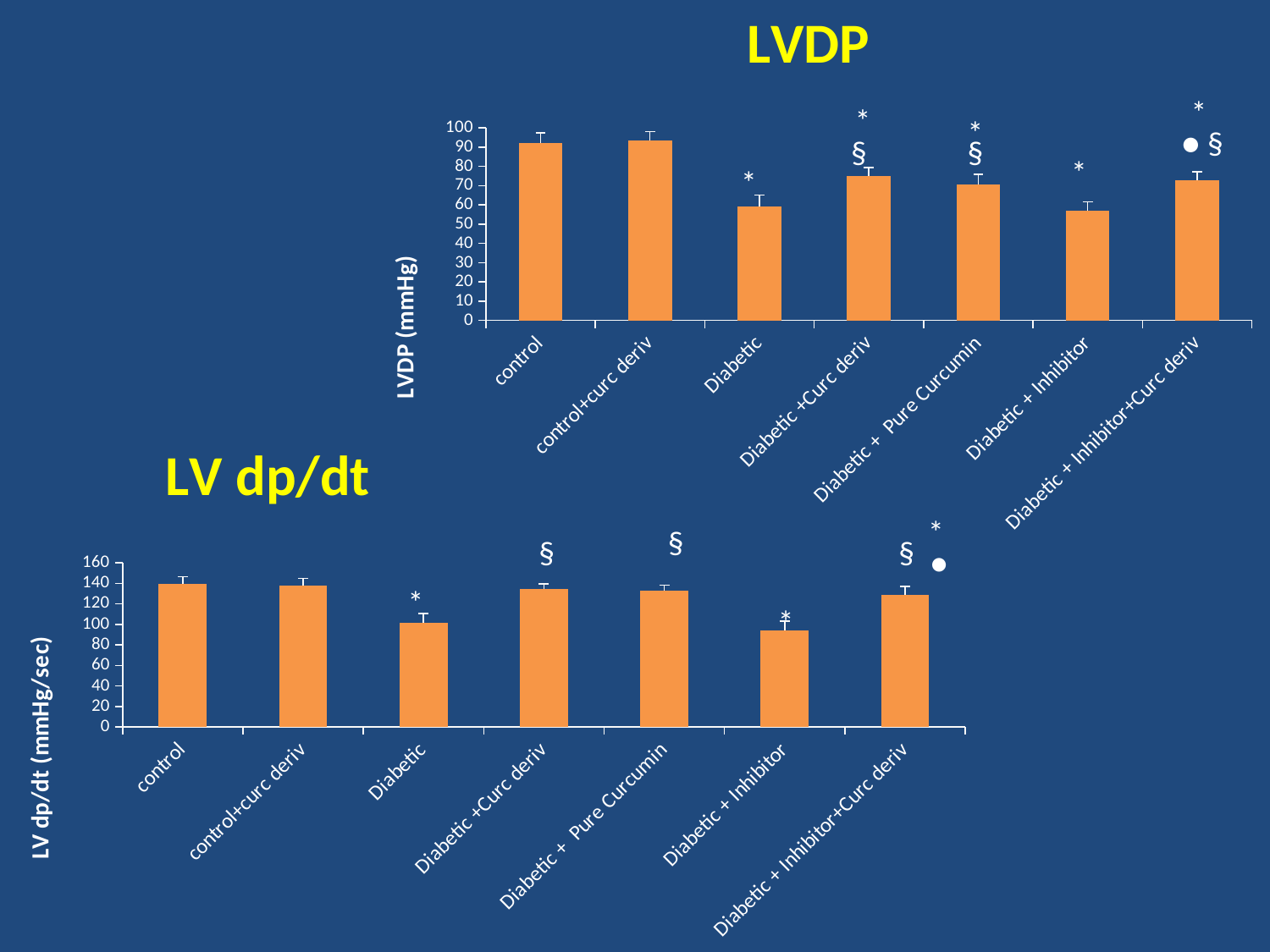
How many categories are shown on the x axis of the LVDP chart? 7 What type of chart is the LVDP chart at the top of the slide? bar chart In the LVDP chart, is the value for Diabetic greater or less than 70? less How many categories are shown on the x axis of the LV dp/dt chart? 7 In the LVDP chart, which is larger, the value for control or the value for Diabetic? control What is the y-axis label of the LV dp/dt chart? LV dp/dt (mmHg/sec) In the LVDP chart, is the value for control greater or less than 80? greater In the LV dp/dt chart, is the value for Diabetic + Inhibitor greater or less than 100? less In the LV dp/dt chart, which is larger, the value for Diabetic or the value for Diabetic +Curc deriv? Diabetic +Curc deriv